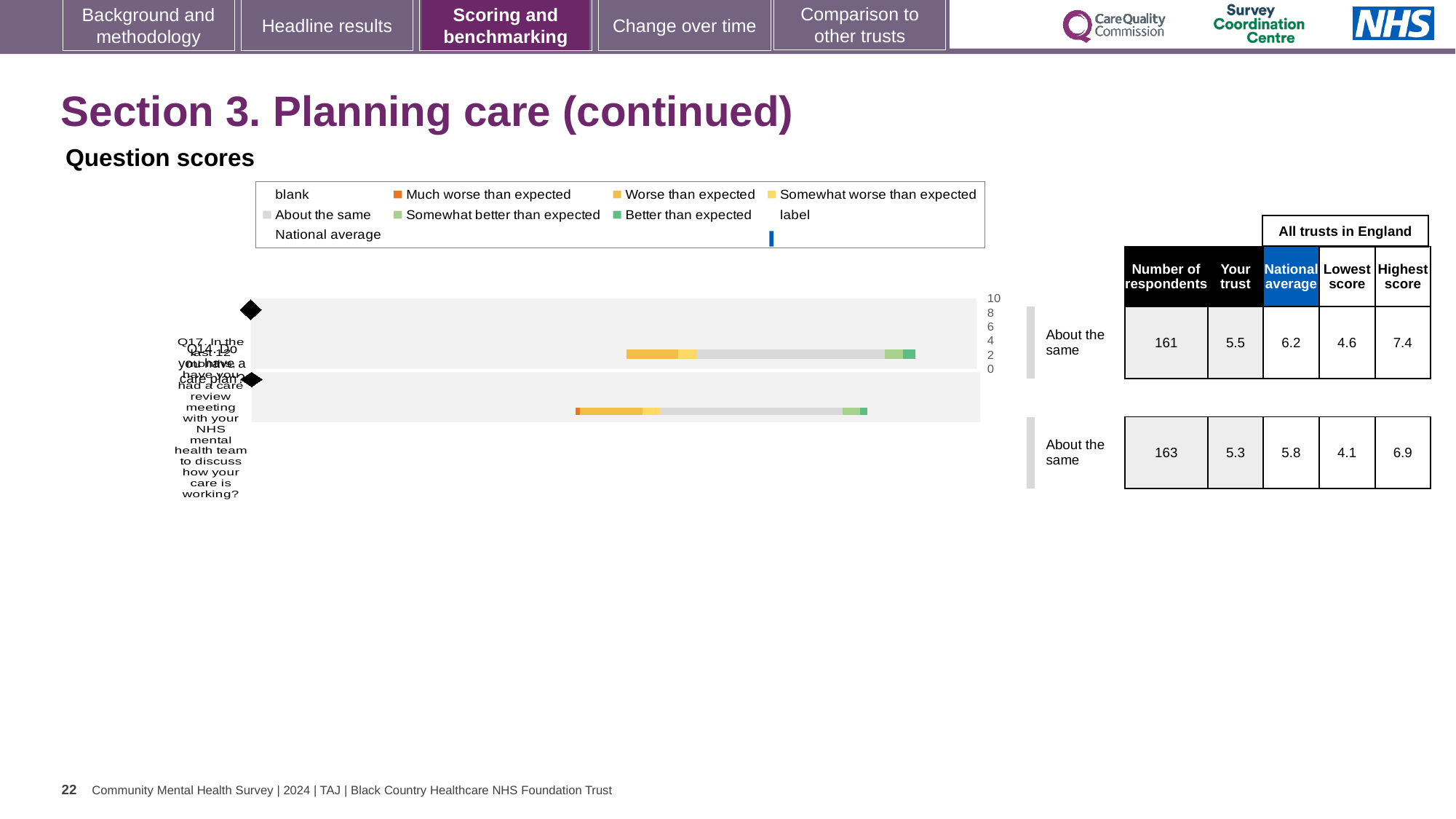
Which question row has the higher number of respondents? The second (163) What is the number of respondents for the first (top) question row? 161 What is the national average for the first (top) question row? 6.2 How many question bars are plotted in the chart? 2 What is the 'Your trust' score for the second (bottom) question row? 5.3 Which question row has the higher 'Your trust' score, the first or the second? The first What is the highest score among all trusts in England for the second (bottom) question row? 6.9 What is the difference between the highest and lowest scores for the second (bottom) question row? 2.8 What benchmark category is shown for both question rows? About the same What kind of chart is shown on the slide? Bar chart What is the difference between the national average and the 'Your trust' score for the first (top) question row? 0.7 What colour does the legend use for 'Much worse than expected'? Orange